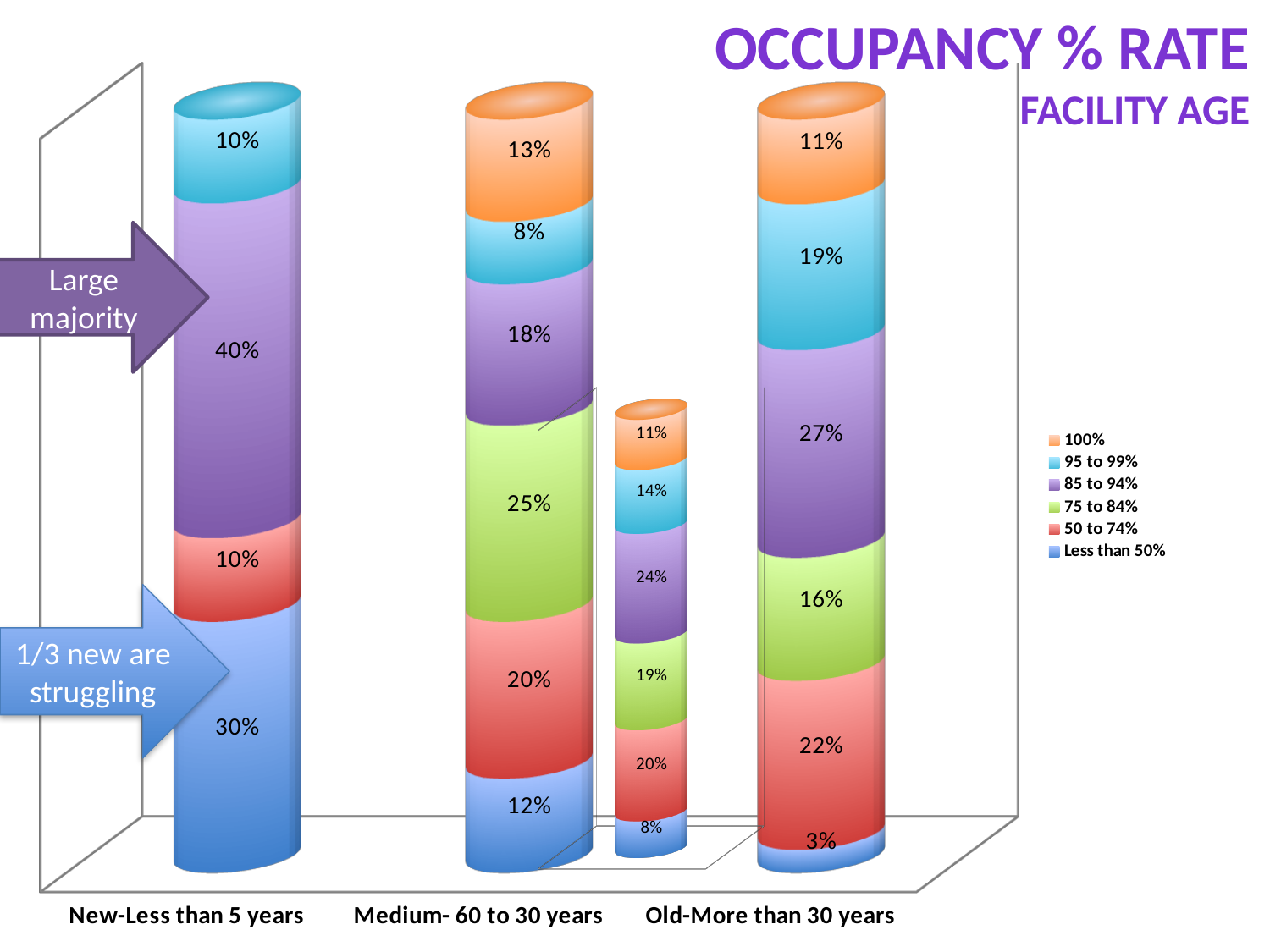
What is the value of the '85 to 94%' segment for 'New-Less than 5 years'? 40% Which facility age category has the smallest 'Less than 50%' segment? Old-More than 30 years What is the value of the '75 to 84%' segment for 'Medium- 60 to 30 years'? 25% What is the title of the chart? OCCUPANCY % RATE FACILITY AGE Which facility age category has the largest 'Less than 50%' segment? New-Less than 5 years What type of chart is shown on the slide? Stacked bar chart What is the value of the 'Less than 50%' segment for 'New-Less than 5 years'? 30% What is the difference between the '85 to 94%' segment for 'New-Less than 5 years' and for 'Old-More than 30 years'? 13% Which is larger: the '95 to 99%' segment for 'Medium- 60 to 30 years' or for 'Old-More than 30 years'? Old-More than 30 years What is the value of the '100%' segment for 'Old-More than 30 years'? 11% How many series does the legend list? 6 What is the value of the '50 to 74%' segment for 'Old-More than 30 years'? 22%